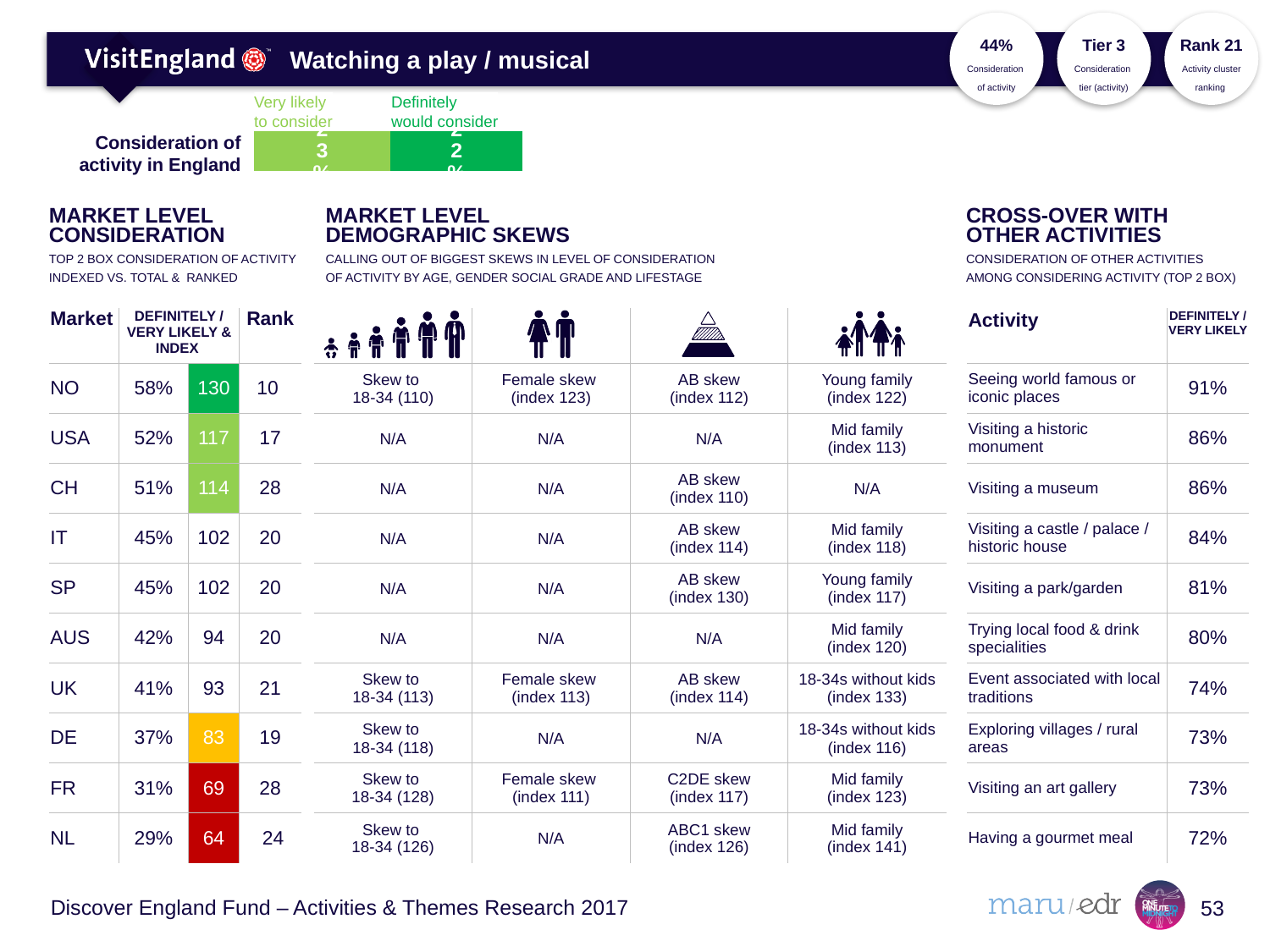
How many segments (series) does the 'Consideration of activity in England' bar chart show? 2 In the 'Consideration of activity in England' chart, what is the value for 'Definitely would consider'? 22% In the 'Consideration of activity in England' chart, which segment is shown in the darker green? Definitely would consider What are the two segment labels shown above the 'Consideration of activity in England' bar chart? Very likely to consider; Definitely would consider In the 'Consideration of activity in England' chart, which segment is larger: 'Very likely to consider' or 'Definitely would consider'? Very likely to consider In the 'Consideration of activity in England' chart, what is the value for 'Very likely to consider'? 23% What kind of chart is the 'Consideration of activity in England' chart? bar chart